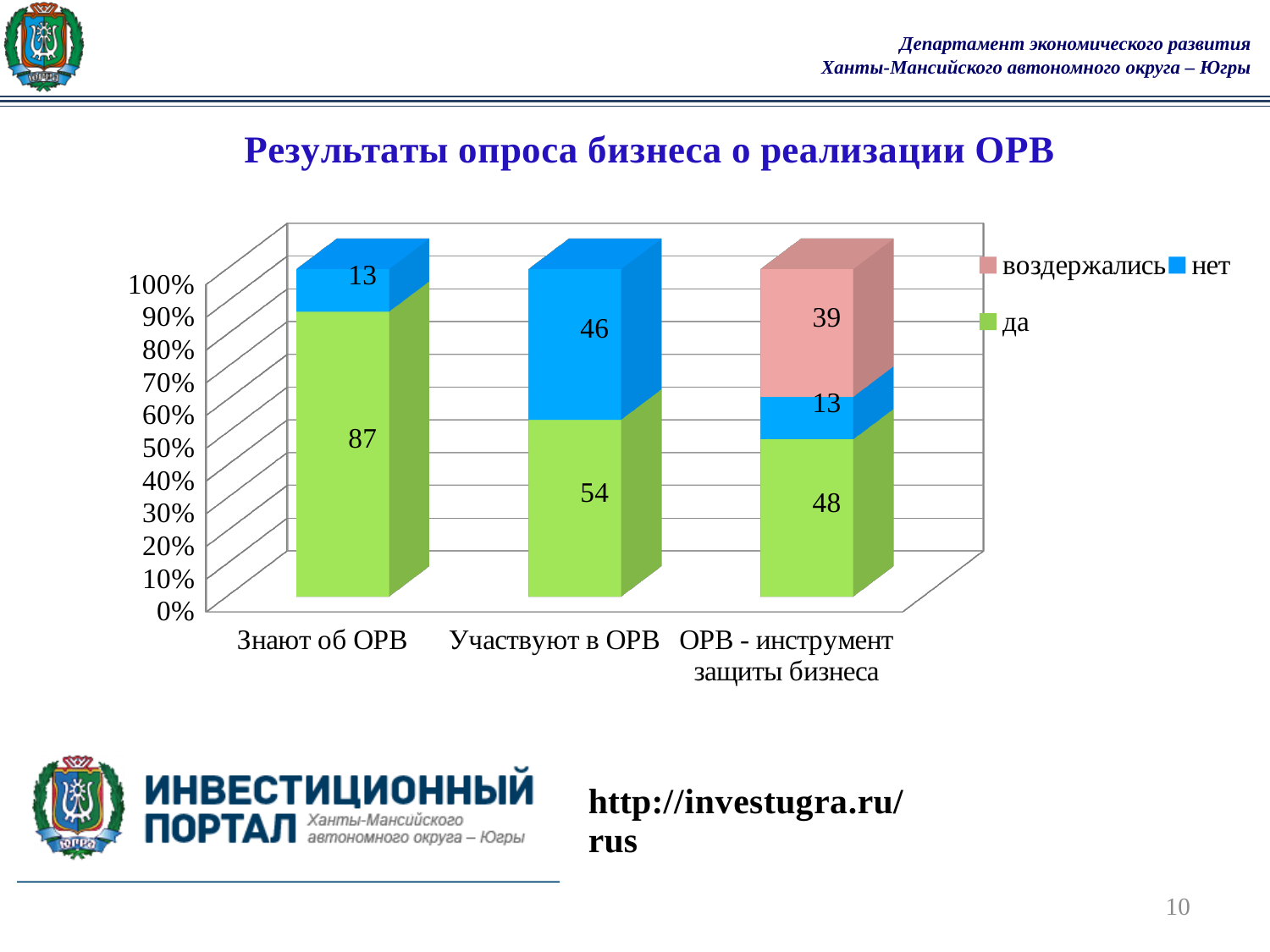
Which category has the lowest value for the "да" series? ОРВ - инструмент защиты бизнеса How many series does the legend list? 3 What is the value of the "да" series for "Знают об ОРВ"? 87 What is the title of the chart on the slide? Результаты опроса бизнеса о реализации ОРВ How many categories are shown on the x axis? 3 Which category has the highest value for the "да" series? Знают об ОРВ What is the value of the "нет" series for "Участвуют в ОРВ"? 46 What is the difference between the "да" and "нет" values for "Участвуют в ОРВ"? 8 What kind of chart is shown on the slide? Stacked bar chart What is the value of the "воздержались" series for "ОРВ - инструмент защиты бизнеса"? 39 What is the value of the "да" series for "ОРВ - инструмент защиты бизнеса"? 48 Which is larger for "Знают об ОРВ": the "да" value or the "нет" value? да